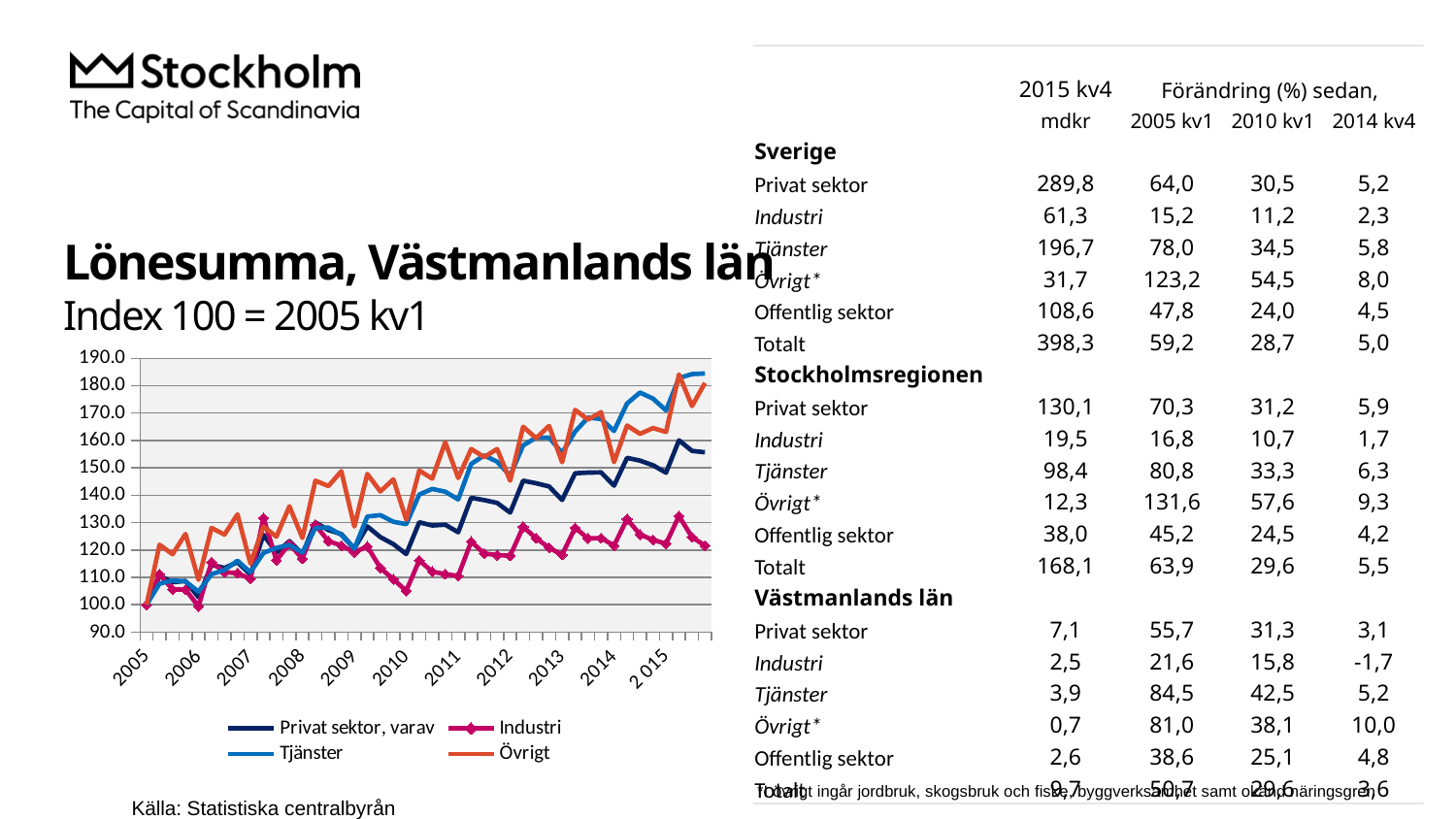
Does the Tjänster series rise or fall overall from 2005 to 2015? rise Is the value for Industri at the end of 2015 greater or less than 140? less What base is the index in the chart set to, according to the subtitle? Index 100 = 2005 kv1 Is the value for Tjänster at the end of 2015 greater or less than 170? greater Is the value for Privat sektor, varav at the end of 2015 greater or less than 140? greater What kind of chart is shown on the slide? line chart Which series has the lowest value at the end of 2015? Industri What is the title of the chart? Lönesumma, Västmanlands län How many series does the chart's legend list? 4 At the end of 2015, which is larger: Tjänster or Industri? Tjänster What is the index value of the series at the start of the chart in 2005? 100